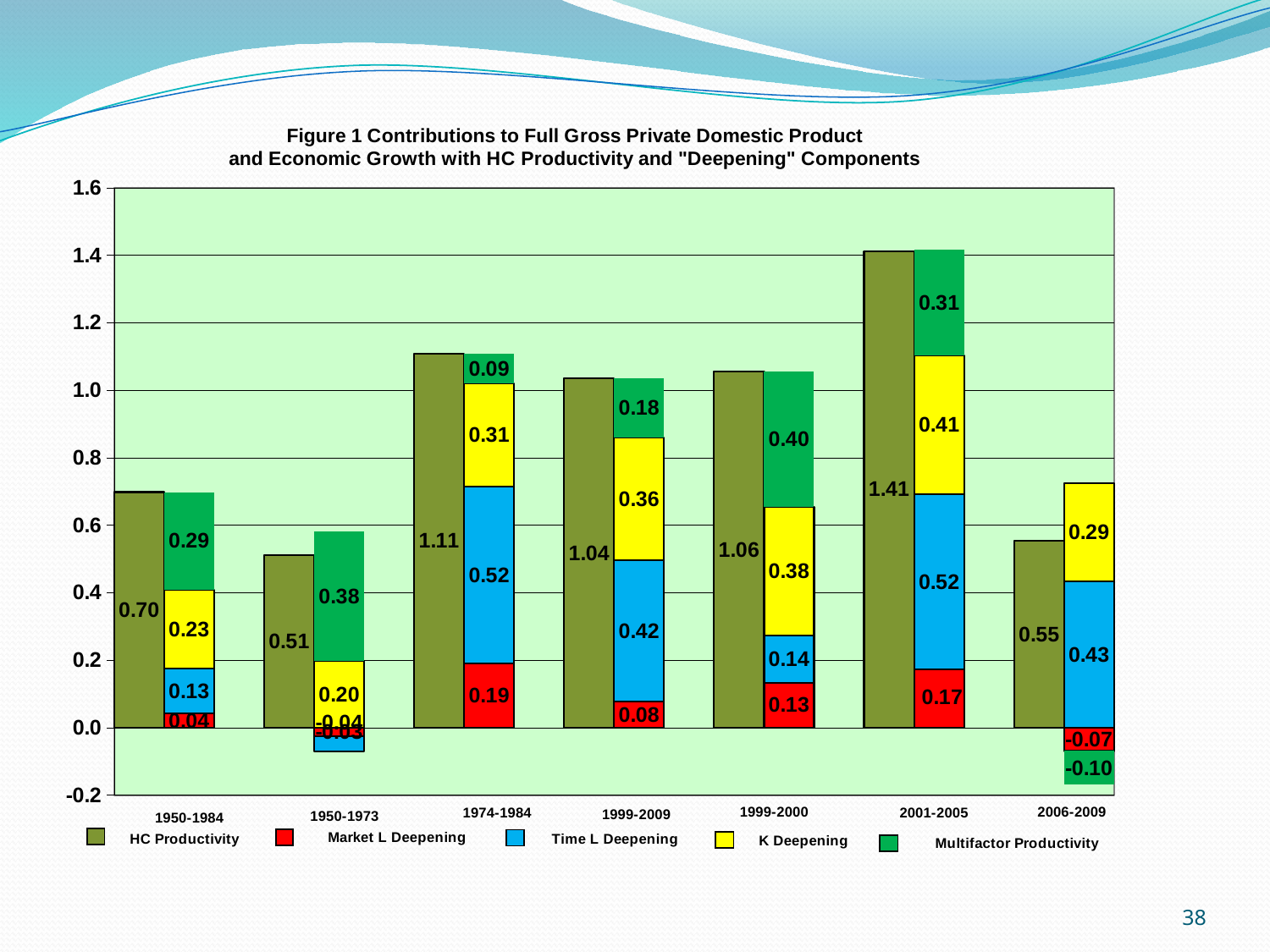
What is the Multifactor Productivity value for 2006-2009? -0.10 What is the total of the stacked components (Market L Deepening, Time L Deepening, K Deepening and Multifactor Productivity) for 1974-1984? 1.11 Which period has the lowest HC Productivity value? 1950-1973 What is the HC Productivity value for 2001-2005? 1.41 What kind of chart is shown on the slide? Bar chart How many periods are shown on the x axis? 7 What is the difference between the Time L Deepening values for 1974-1984 and 1999-2009? 0.10 What colour represents K Deepening in the legend? Yellow Which period has the highest HC Productivity value? 2001-2005 What is the K Deepening value for 1999-2000? 0.38 How many series does the legend list? 5 Which period has the larger Multifactor Productivity value, 1999-2000 or 2001-2005? 1999-2000